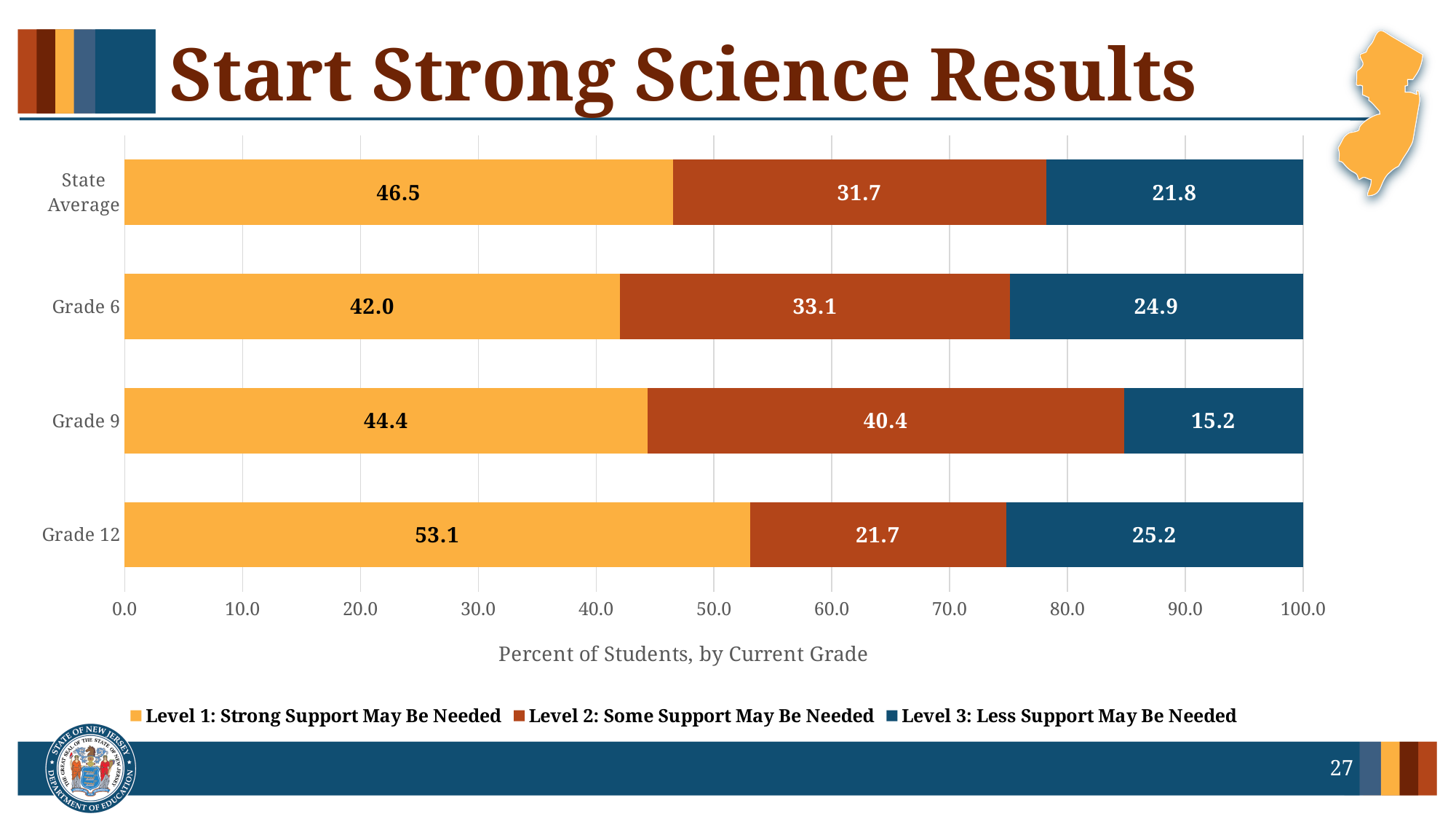
What is the x-axis title of the chart? Percent of Students, by Current Grade How many categories are shown on the y axis? 4 Which grade has the highest Level 2 value? Grade 9 What is the difference between the Level 1 values for Grade 12 and Grade 6? 11.1 What is the total of the stacked bar for Grade 6? 100.0 What is the Level 1 value for Grade 12? 53.1 What kind of chart is shown? Stacked bar chart Which is larger, the Level 3 value for Grade 6 or for Grade 12? Grade 12 What is the Level 3 value for Grade 9? 15.2 What is the Level 2 value for the State Average? 31.7 How many series does the legend list? 3 Which category has the lowest Level 3 value? Grade 9